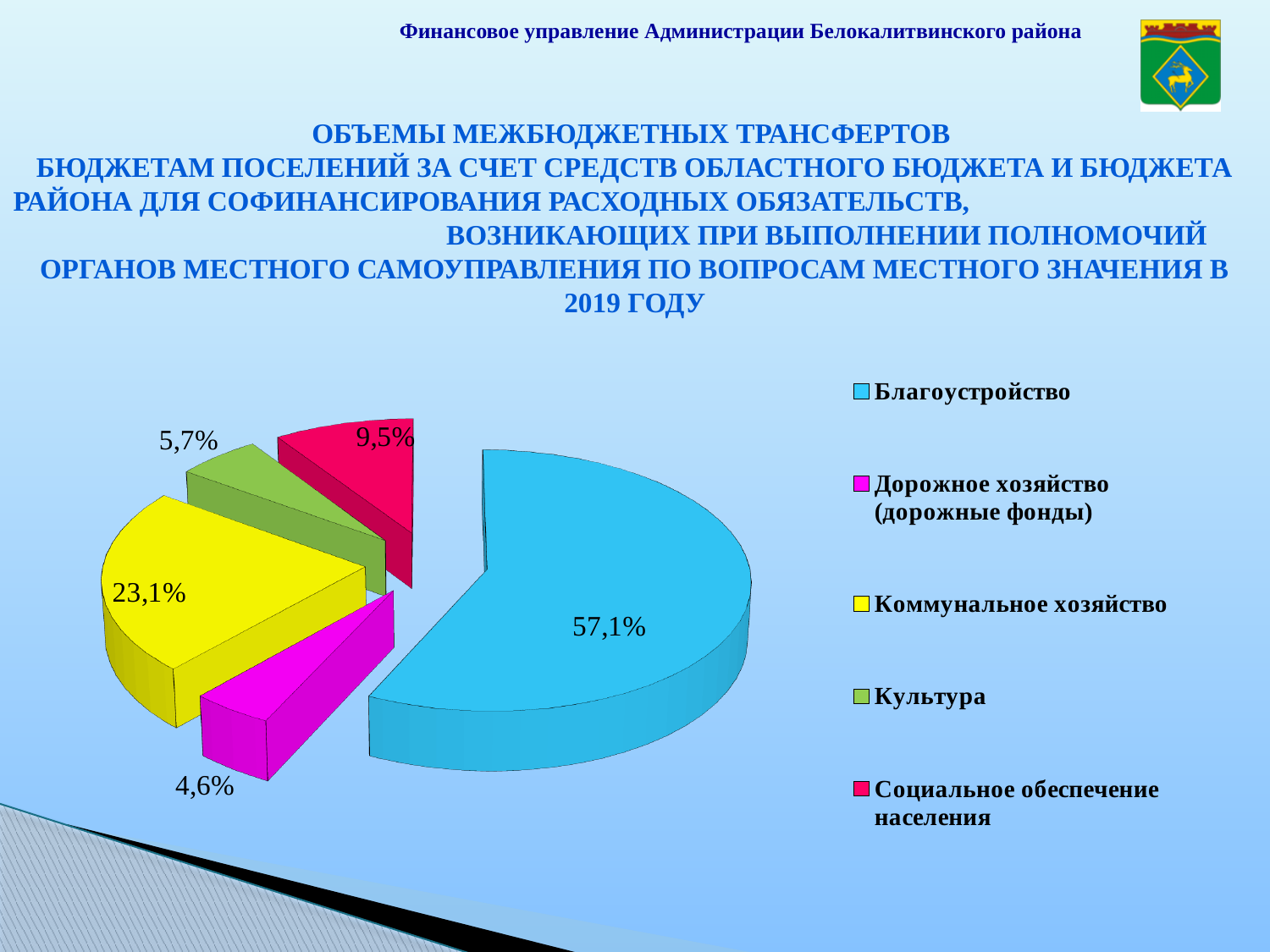
How many categories does the pie chart show? 5 What is the difference in percentage points between Благоустройство and Коммунальное хозяйство? 34,0 What is the value shown for Социальное обеспечение населения? 9,5% Which category has the smallest slice of the pie? Дорожное хозяйство (дорожные фонды) What is the value shown for Дорожное хозяйство (дорожные фонды)? 4,6% Which category has the largest slice of the pie? Благоустройство What is the value shown for Коммунальное хозяйство? 23,1% What is the value shown for Культура? 5,7% Which is larger, the share for Социальное обеспечение населения or the share for Культура? Социальное обеспечение населения What share of the pie does Благоустройство account for? 57,1% What type of chart is shown on the slide? Pie chart What colour is the slice for Коммунальное хозяйство? Yellow